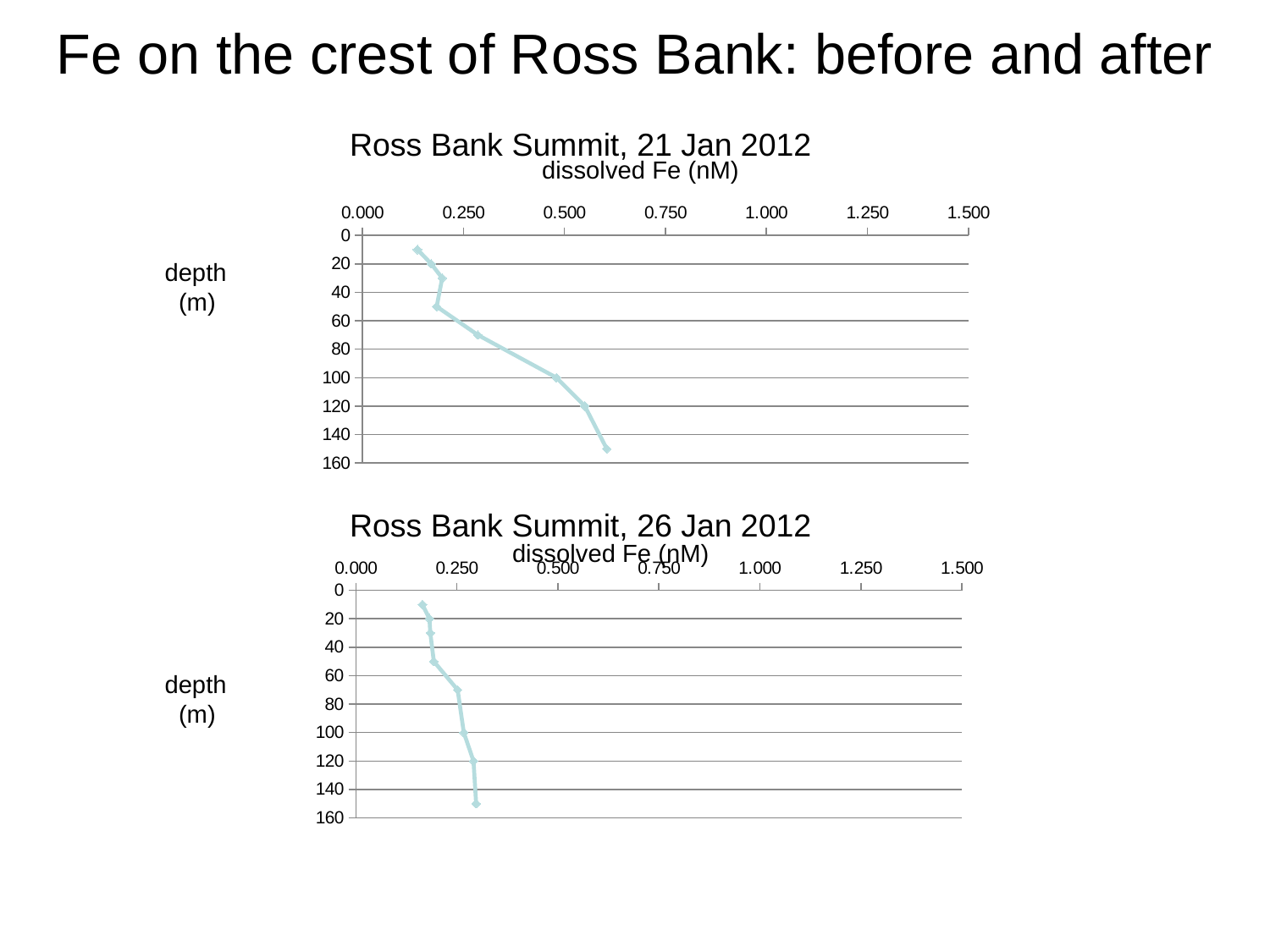
What is the title of the top chart? Ross Bank Summit, 21 Jan 2012 In the top chart (21 Jan 2012), at which depth is the dissolved Fe value highest? 150 m In the bottom chart (26 Jan 2012), is the dissolved Fe value at 150 m depth greater or less than 0.250 nM? greater In the bottom chart (26 Jan 2012), does dissolved Fe generally increase or decrease as depth increases? increase How many data points are plotted in the bottom chart (26 Jan 2012)? 8 In the top chart (21 Jan 2012), does dissolved Fe generally increase or decrease as depth increases? increase In the top chart (21 Jan 2012), is the dissolved Fe value at 150 m depth greater or less than 0.500 nM? greater What kind of chart is the top chart (21 Jan 2012)? line chart In the bottom chart (26 Jan 2012), is the dissolved Fe value at 150 m depth greater or less than 0.500 nM? less What is the title of the bottom chart? Ross Bank Summit, 26 Jan 2012 At 150 m depth, which chart shows the higher dissolved Fe value, the top chart (21 Jan 2012) or the bottom chart (26 Jan 2012)? top chart (21 Jan 2012)